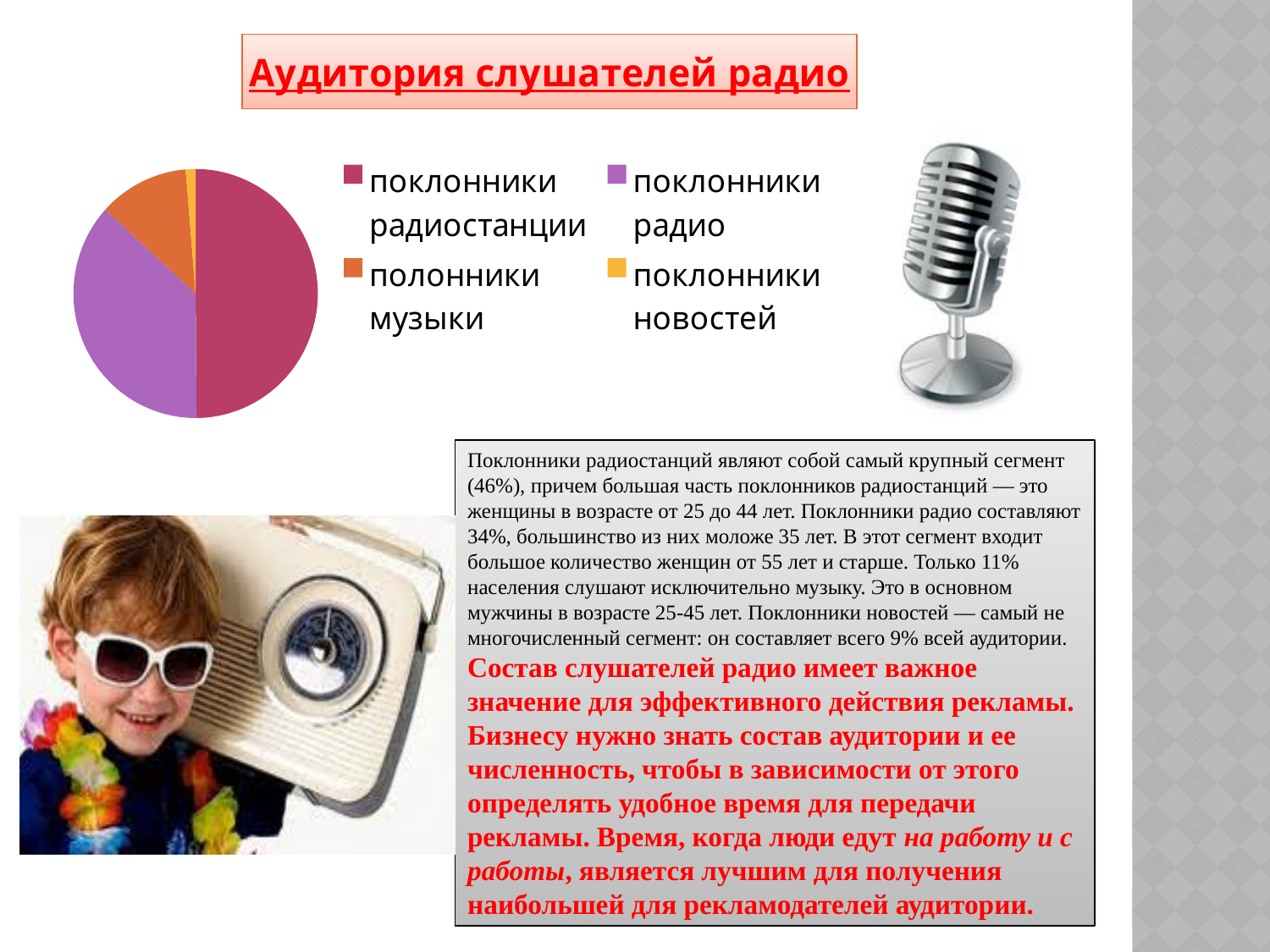
How many entries does the legend of the pie chart list? 4 How many slices does the pie chart have? 4 Which category has the smallest slice of the pie chart? поклонники новостей What kind of chart is shown on the slide? pie chart Which slice is larger: поклонники радиостанции or поклонники радио? поклонники радиостанции What colour is the slice for поклонники радио in the pie chart? purple What is the title shown above the pie chart on the slide? Аудитория слушателей радио Which slice is larger: полонники музыки or поклонники новостей? полонники музыки Which slice is larger: поклонники радио or полонники музыки? поклонники радио Which category has the largest slice of the pie chart? поклонники радиостанции